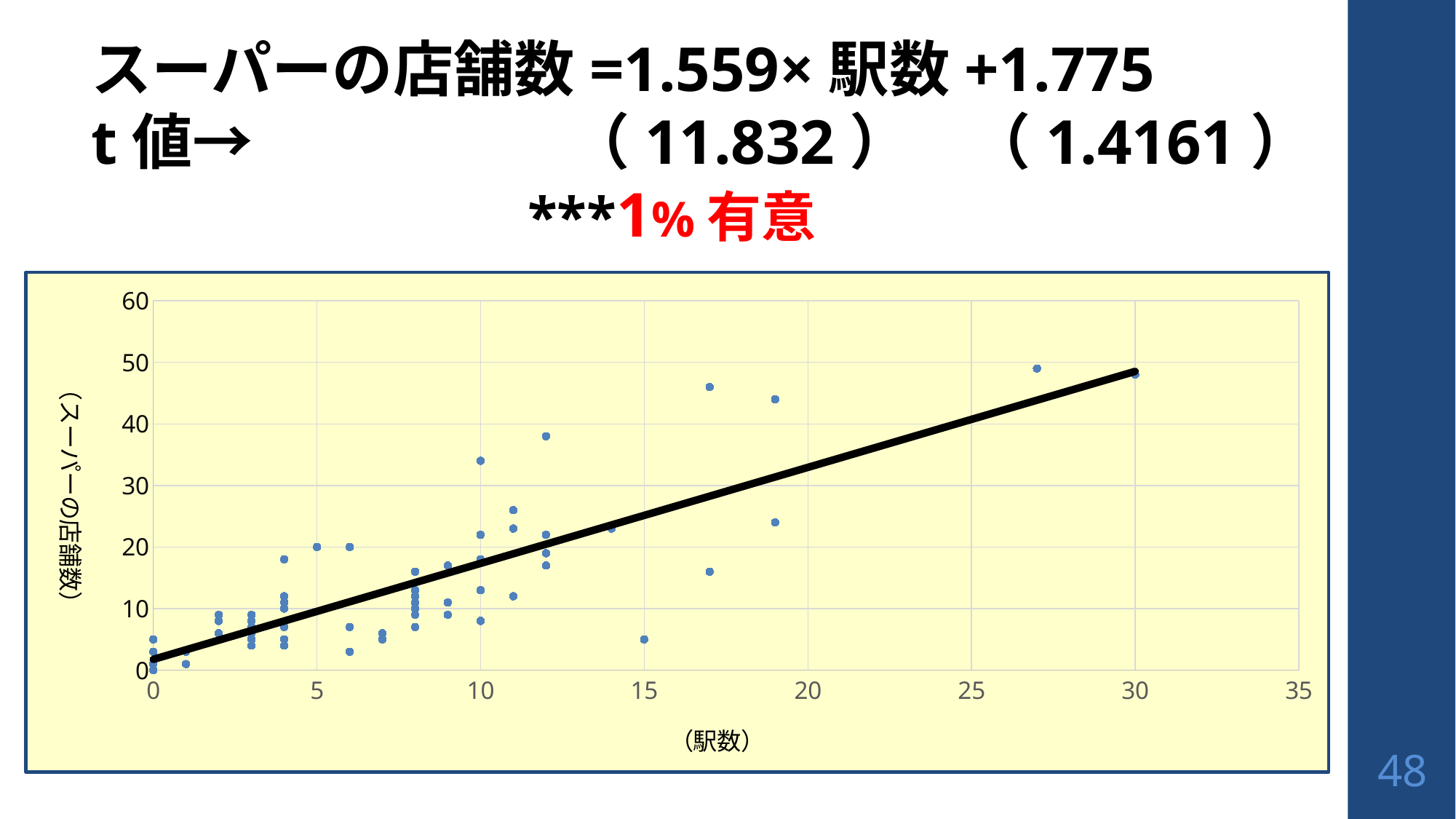
Is the value for the lowest point at 6 stations greater or less than 10? less What is the highest tick value shown on the x axis? 35 Is the value for the highest point at 17 stations greater or less than 40? greater What is the label of the y axis of the chart? （スーパーの店舗数） What is the label of the x axis of the chart? （駅数） Is the value for the point at 27 stations greater or less than 40? greater What is the highest tick value shown on the y axis? 60 Do the plotted values generally rise or fall as the number of stations (駅数) increases along the x axis? rise What kind of chart is shown on the slide? scatter chart